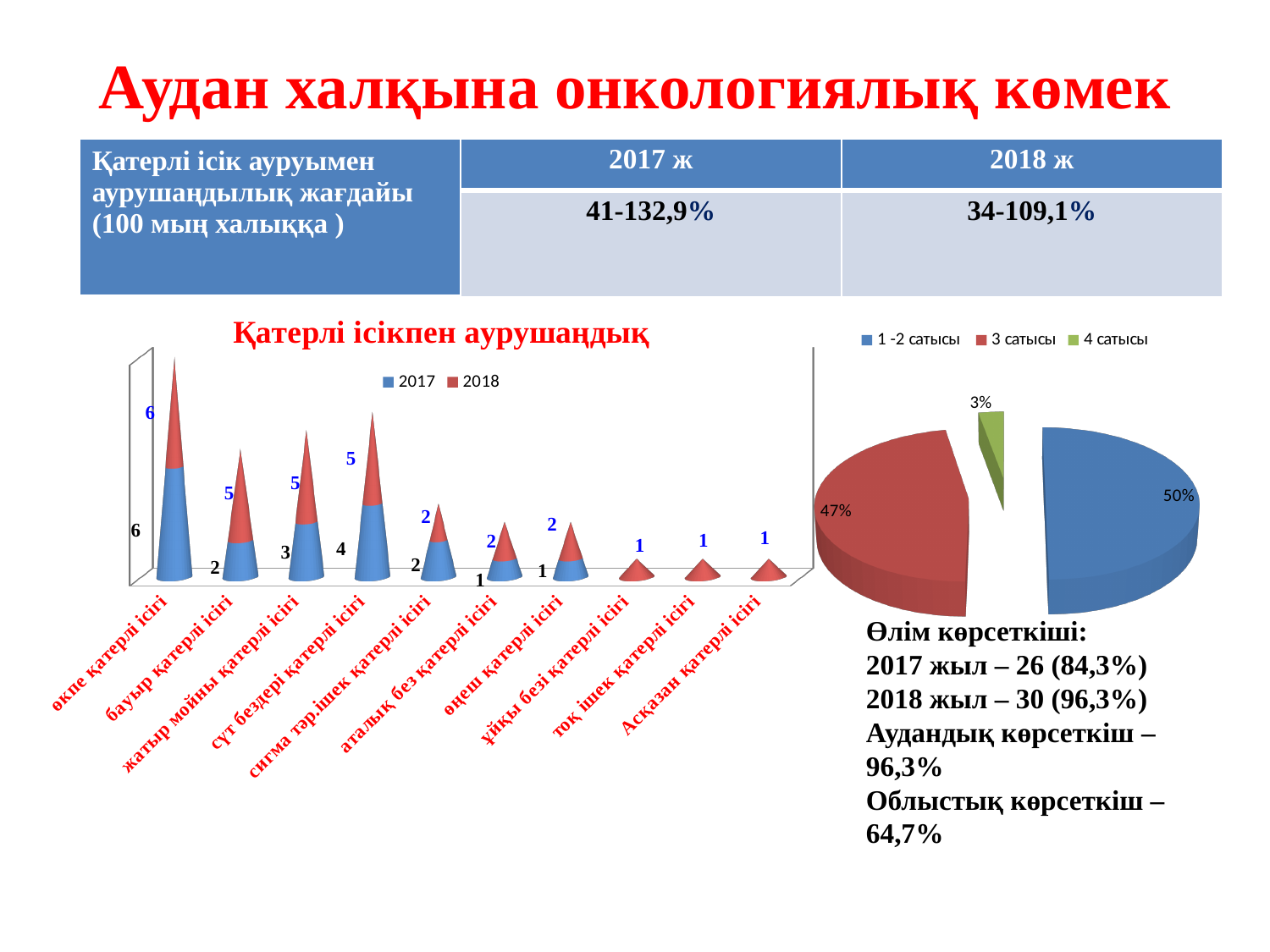
In the chart "Қатерлі ісікпен аурушаңдық", what is the 2017 value for сүт бездері қатерлі ісігі? 4 In the pie chart on the right, which slice is the smallest? 4 сатысы How many series does the legend of the chart "Қатерлі ісікпен аурушаңдық" list? 2 In the pie chart on the right, what share does "1 -2 сатысы" have? 50% In the pie chart on the right, what is the difference in percentage points between the "1 -2 сатысы" slice and the "3 сатысы" slice? 3 In the pie chart on the right, what share does "3 сатысы" have? 47% In the chart "Қатерлі ісікпен аурушаңдық", which category has the tallest bar? өкпе қатерлі ісігі In the pie chart on the right, how many slices does the legend list? 3 What kind of chart is the chart on the right of the slide with the legend "1 -2 сатысы", "3 сатысы", "4 сатысы"? pie chart In the chart "Қатерлі ісікпен аурушаңдық", what is the 2018 value for бауыр қатерлі ісігі? 5 What kind of chart is the chart titled "Қатерлі ісікпен аурушаңдық"? bar chart How many categories are shown on the x axis of the chart "Қатерлі ісікпен аурушаңдық"? 10